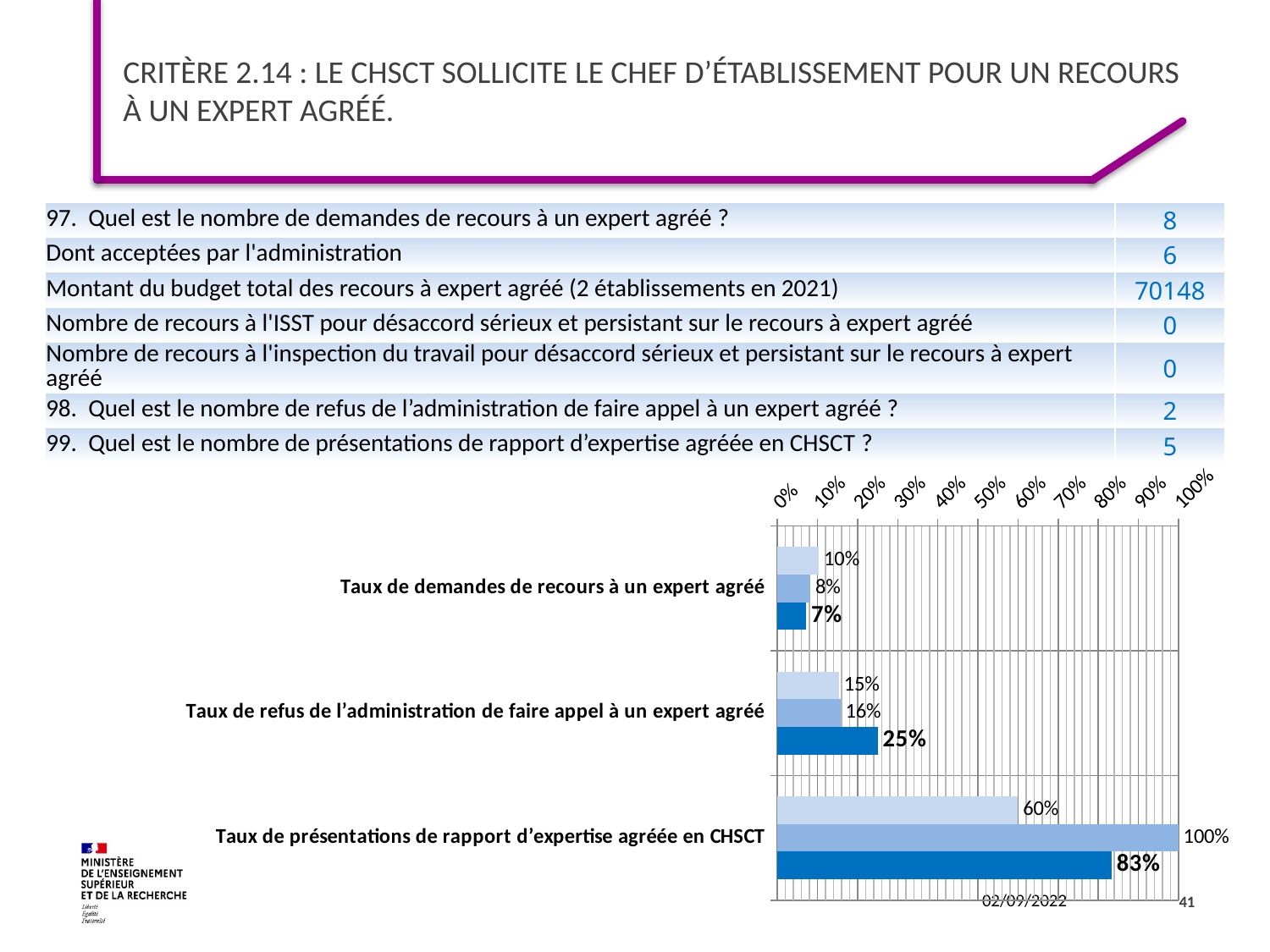
What is the difference between the middle bar (100%) and the dark blue bar (83%) for 'Taux de présentations de rapport d’expertise agréée en CHSCT'? 17% What is the value of the dark blue (bottom) bar for 'Taux de refus de l’administration de faire appel à un expert agréé'? 25% Which category has the lowest value among the dark blue (bottom) bars? Taux de demandes de recours à un expert agréé How many bars are shown for each category on the chart? 3 What is the value of the middle bar for 'Taux de présentations de rapport d’expertise agréée en CHSCT'? 100% What is the value of the dark blue (bottom) bar for 'Taux de demandes de recours à un expert agréé'? 7% For 'Taux de refus de l’administration de faire appel à un expert agréé', which is larger: the lightest blue (top) bar or the dark blue (bottom) bar? the dark blue (bottom) bar How many categories are shown on the bar chart? 3 What is the value of the lightest blue (top) bar for 'Taux de présentations de rapport d’expertise agréée en CHSCT'? 60% What kind of chart is shown at the bottom of the slide? bar chart What is the value of the dark blue (bottom) bar for 'Taux de présentations de rapport d’expertise agréée en CHSCT'? 83% Which category has the highest value among the dark blue (bottom) bars? Taux de présentations de rapport d’expertise agréée en CHSCT